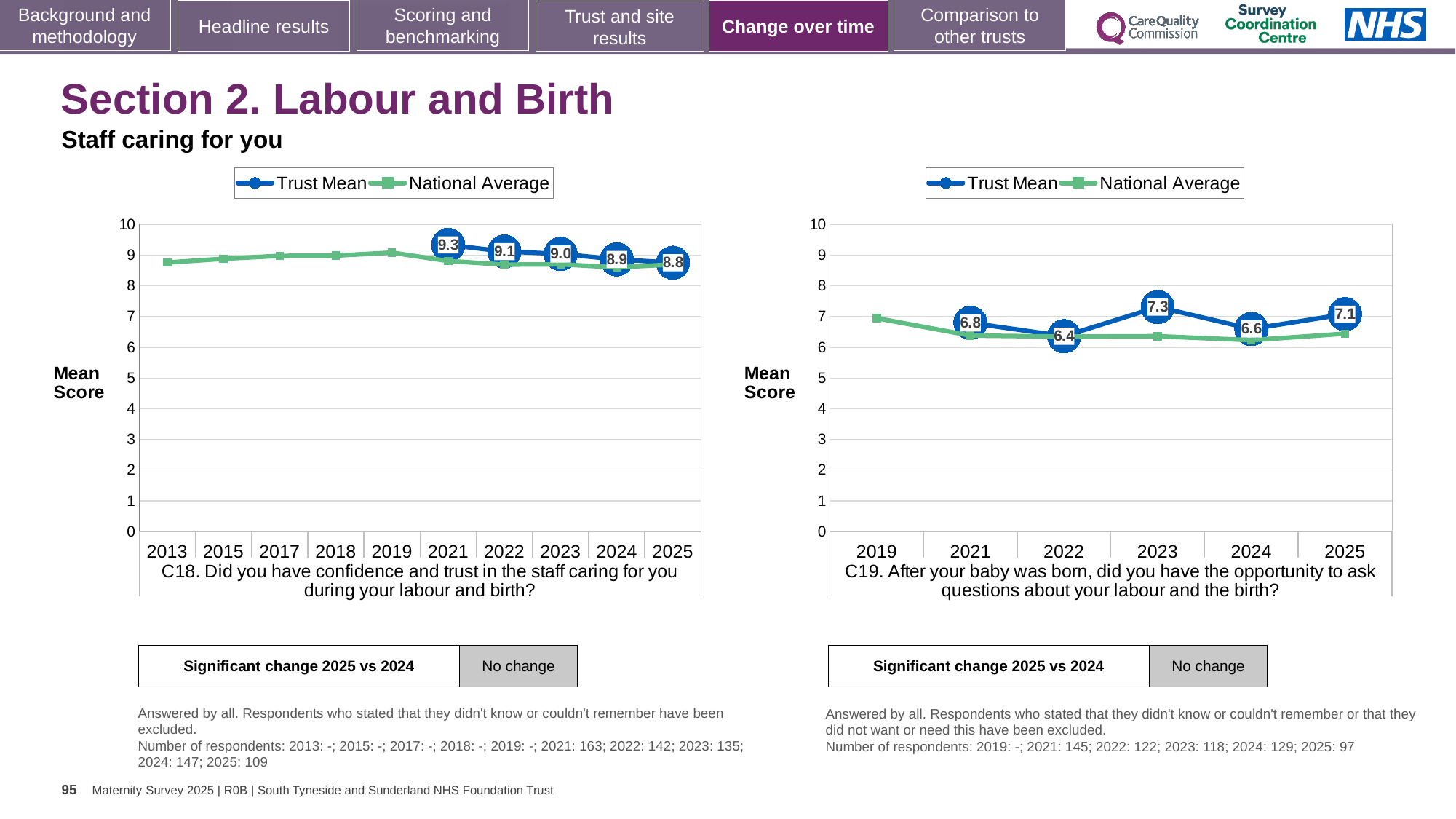
In the C19 chart, is the National Average value for 2019 greater or less than 5? greater In the C18 chart, does the Trust Mean score rise or fall from 2021 to 2025? fall What kind of chart is the C18 chart? line chart In the C18 chart, what is the Trust Mean score for 2025? 8.8 How many years are shown on the x axis of the C18 chart? 10 In the C18 chart, what is the Trust Mean score for 2021? 9.3 In the C19 chart, what is the Trust Mean score for 2023? 7.3 In the C19 chart, is the Trust Mean score for 2025 higher or lower than for 2024? higher In the C19 chart, which year has the highest Trust Mean score? 2023 In the C19 chart, which year has the lowest Trust Mean score? 2022 How many series does the legend of the C19 chart list? 2 In the C18 chart, what is the difference between the Trust Mean scores for 2021 and 2025? 0.5